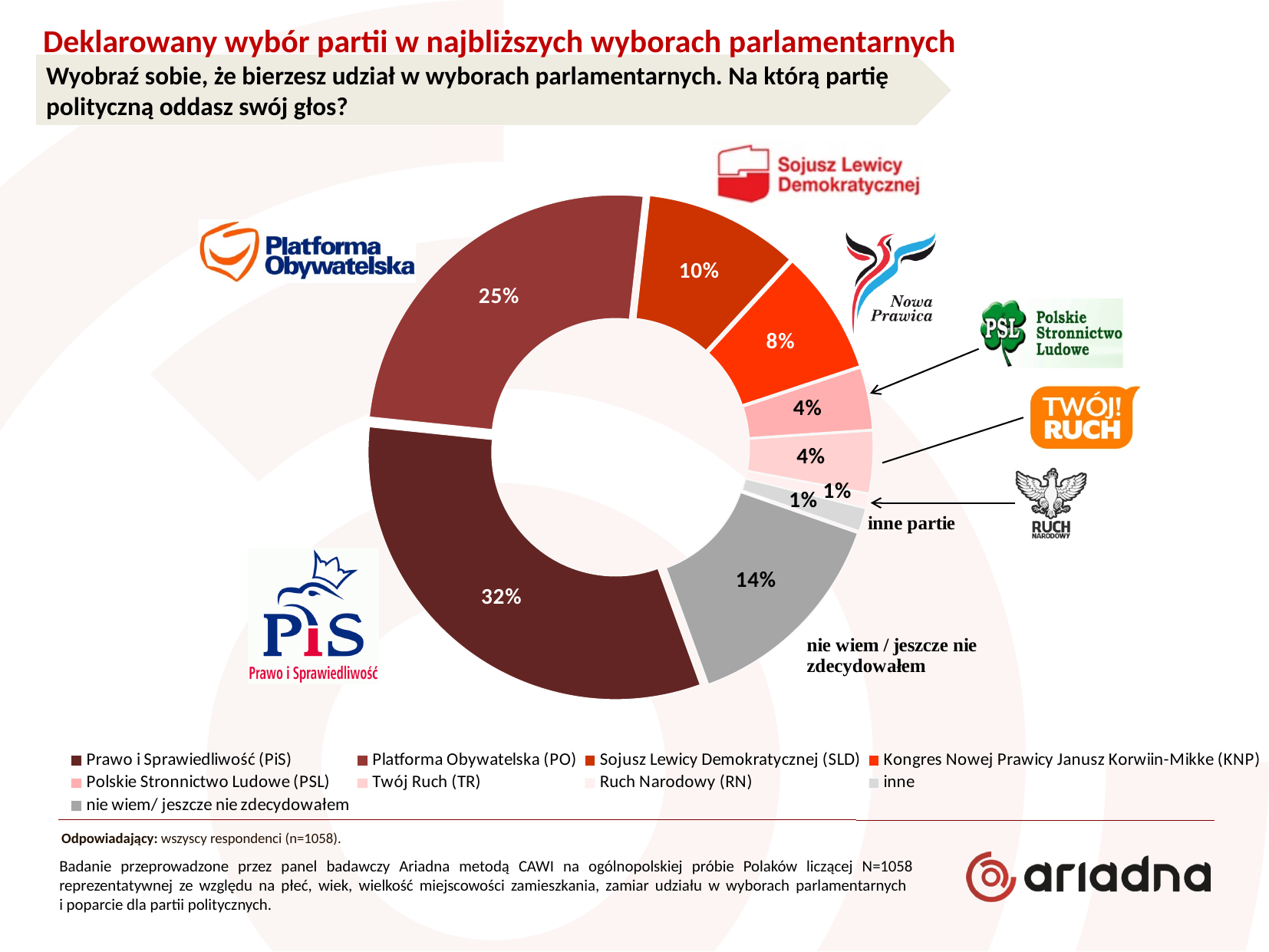
What share of respondents declared they would vote for Platforma Obywatelska (PO)? 25% What is the combined share of Polskie Stronnictwo Ludowe (PSL) and Twój Ruch (TR)? 8% What kind of chart is shown on the slide? Pie (donut) chart What percentage of respondents chose Sojusz Lewicy Demokratycznej (SLD)? 10% What share of respondents chose Kongres Nowej Prawicy Janusz Korwin-Mikke (KNP)? 8% What share of respondents declared they would vote for Prawo i Sprawiedliwość (PiS)? 32% How many entries does the legend list? 9 Which is larger: the share for Sojusz Lewicy Demokratycznej (SLD) or for Kongres Nowej Prawicy (KNP)? Sojusz Lewicy Demokratycznej (SLD) Which party has the largest share in the chart? Prawo i Sprawiedliwość (PiS) What percentage of respondents answered 'nie wiem / jeszcze nie zdecydowałem'? 14% What is the difference in percentage points between the PiS share and the PO share? 7 What is the title of the slide's chart? Deklarowany wybór partii w najbliższych wyborach parlamentarnych